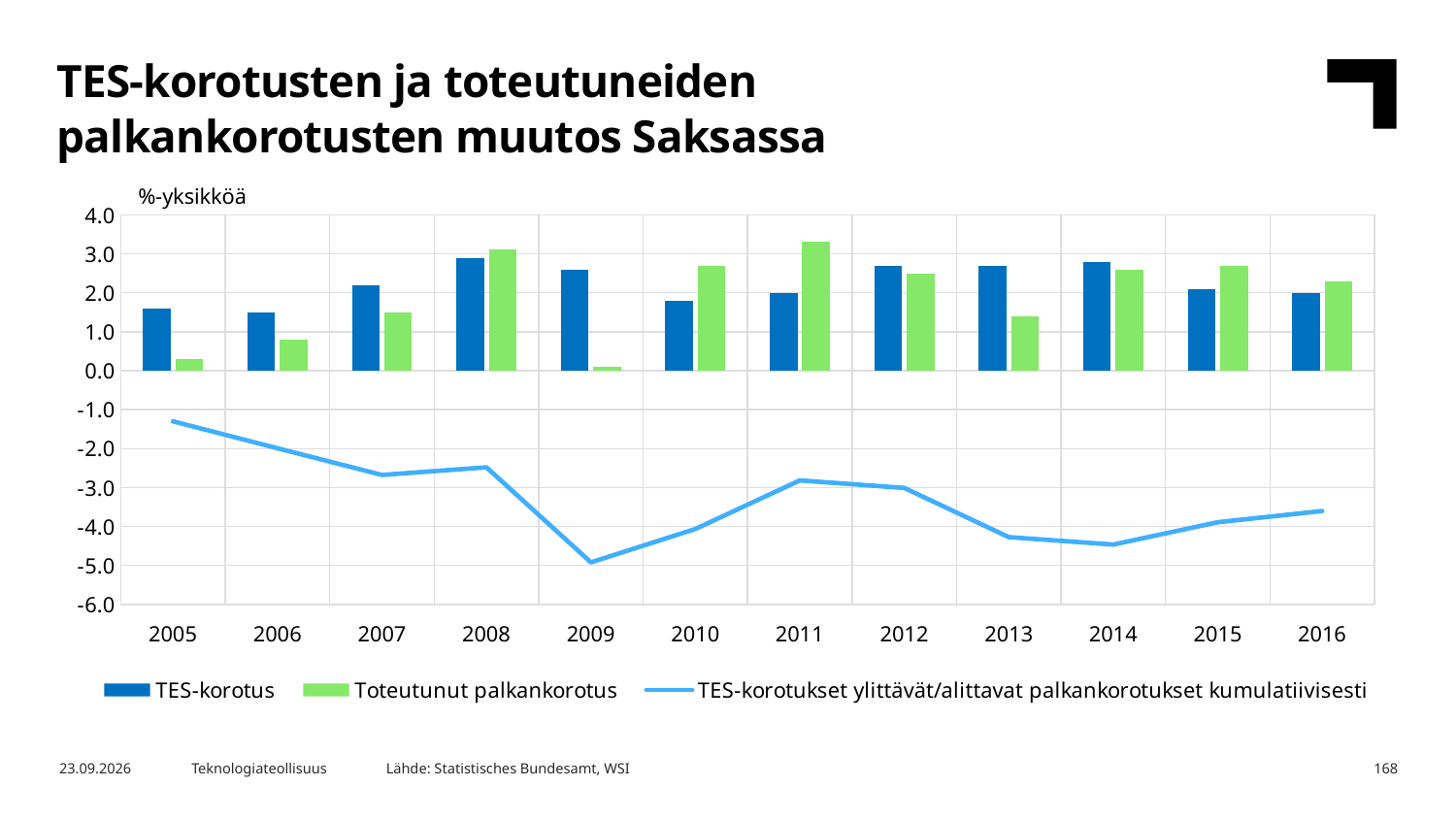
Is the value of the cumulative line (TES-korotukset ylittävät/alittavat palkankorotukset kumulatiivisesti) in 2009 greater or less than -4.0? less In 2009, which is larger: TES-korotus or Toteutunut palkankorotus? TES-korotus How many years are shown on the x axis of the chart? 12 Is the Toteutunut palkankorotus value for 2005 greater or less than 1.0? less Does the cumulative line rise or fall from 2005 to 2009? It falls What kind of chart is shown on the slide? A combined bar and line chart In which year does the cumulative line (TES-korotukset ylittävät/alittavat palkankorotukset kumulatiivisesti) reach its lowest point? 2009 In which year is the Toteutunut palkankorotus bar the lowest? 2009 How many series does the chart legend list? 3 In which year is the Toteutunut palkankorotus bar the highest? 2011 What unit label is shown above the y axis of the chart? %-yksikköä In 2011, which is larger: TES-korotus or Toteutunut palkankorotus? Toteutunut palkankorotus